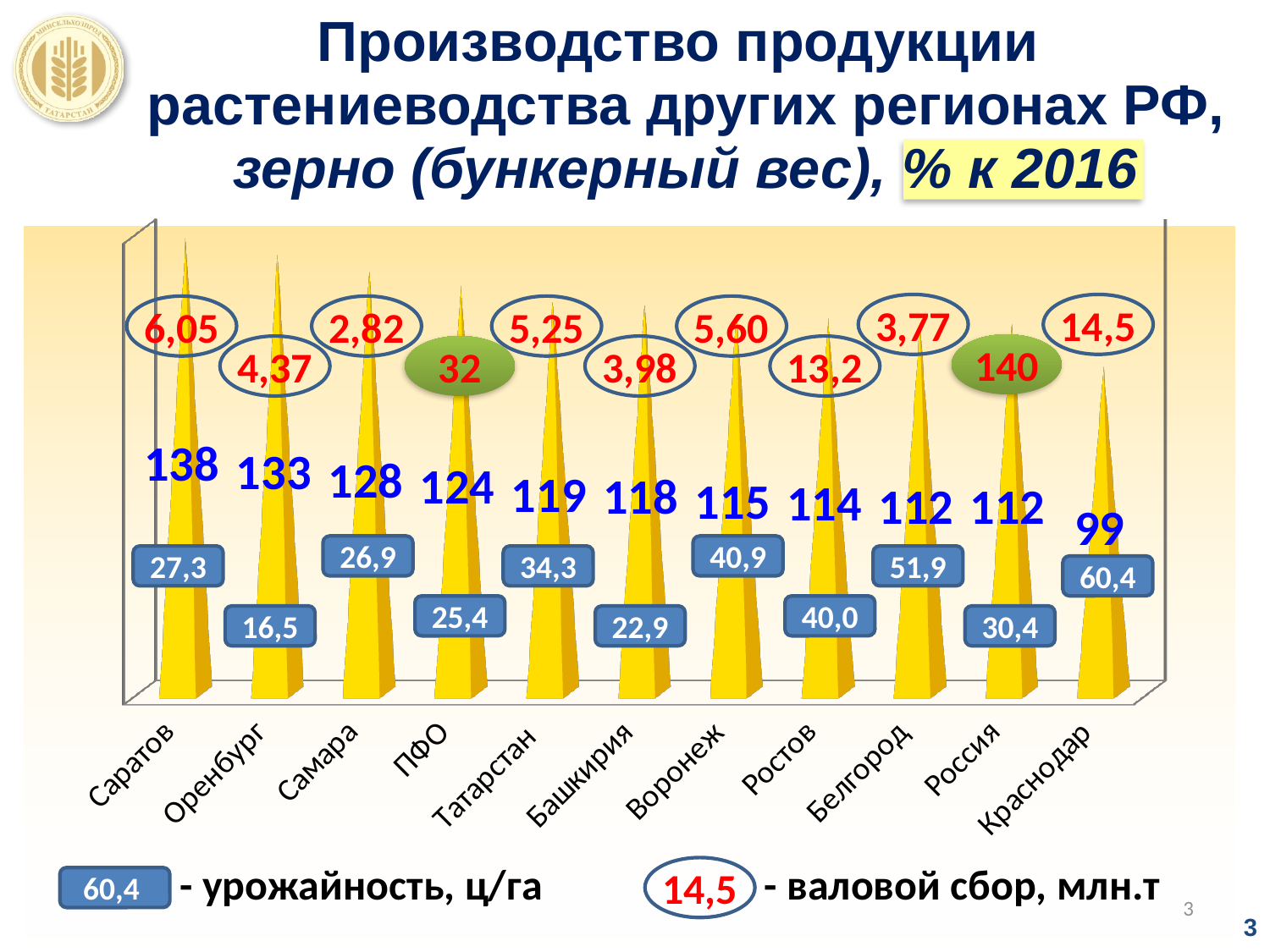
What is the gross harvest (валовой сбор, млн.т) shown for Ростов? 13,2 What kind of chart is shown on the slide? bar chart What is the difference between the values (% к 2016) for Саратов and Краснодар? 39 Which region has the lowest value (% к 2016) on the chart? Краснодар What is the value (% к 2016) plotted for Саратов? 138 What is the yield (урожайность, ц/га) shown for Белгород? 51,9 What is the value (% к 2016) plotted for Краснодар? 99 Which has a larger value (% к 2016): Оренбург or Татарстан? Оренбург How many regions (categories) are shown on the chart? 11 According to the legend, what does the value in the blue rectangle represent? урожайность, ц/га Do the values (% к 2016) rise or fall from left to right along the x axis? fall Which region has the highest value (% к 2016) on the chart? Саратов